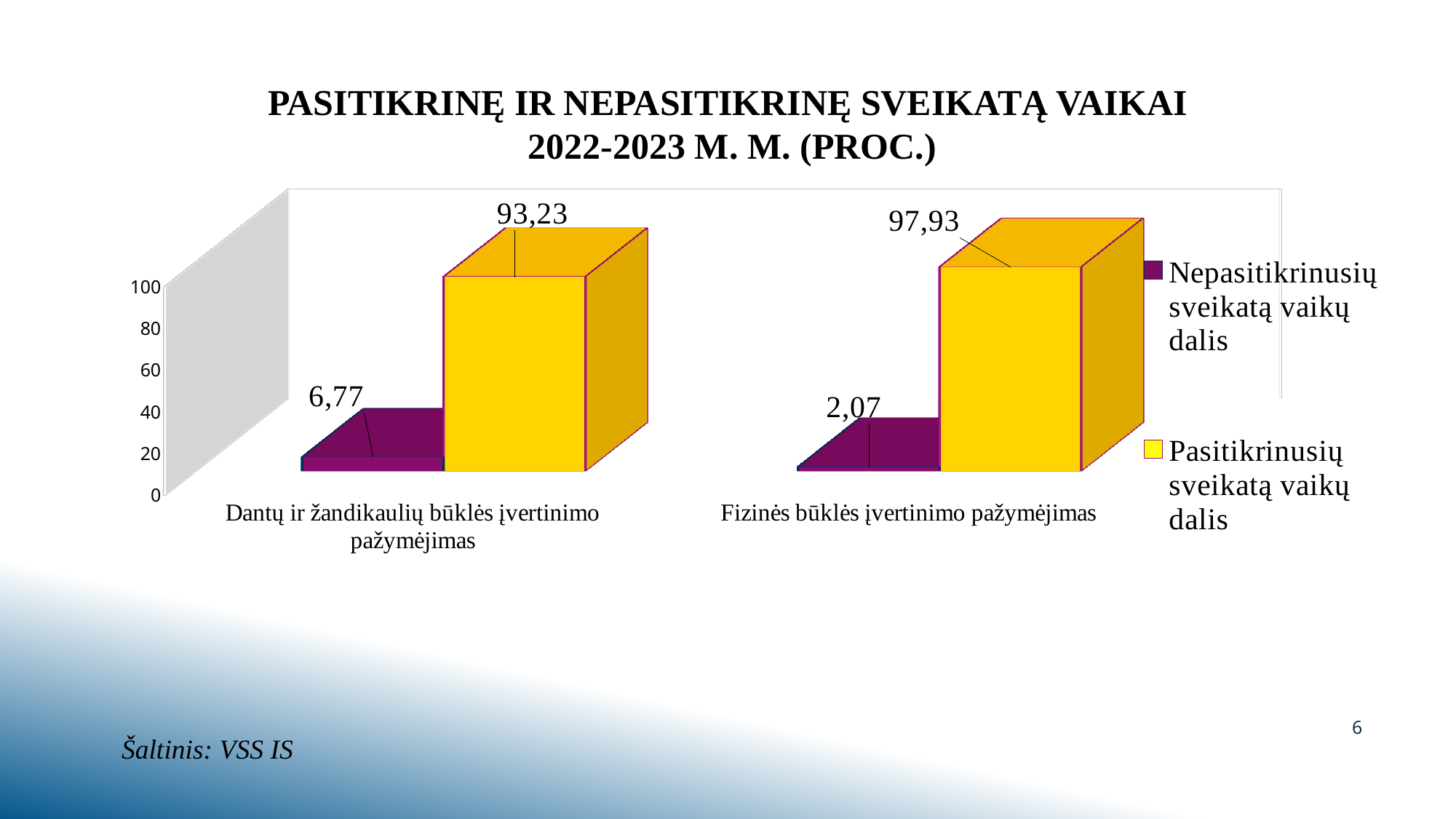
What is the difference between the "Pasitikrinusių sveikatą vaikų dalis" values for the two categories? 4,7 What is the value for "Nepasitikrinusių sveikatą vaikų dalis" in the "Fizinės būklės įvertinimo pažymėjimas" category? 2,07 What kind of chart is shown on the slide? bar chart Which category has the lowest value for "Nepasitikrinusių sveikatą vaikų dalis"? Fizinės būklės įvertinimo pažymėjimas Which category has the highest value for "Pasitikrinusių sveikatą vaikų dalis"? Fizinės būklės įvertinimo pažymėjimas What is the value for "Pasitikrinusių sveikatą vaikų dalis" in the "Fizinės būklės įvertinimo pažymėjimas" category? 97,93 What is the value for "Nepasitikrinusių sveikatą vaikų dalis" in the "Dantų ir žandikaulių būklės įvertinimo pažymėjimas" category? 6,77 Which is larger: the "Nepasitikrinusių sveikatą vaikų dalis" value for "Dantų ir žandikaulių būklės įvertinimo pažymėjimas" or for "Fizinės būklės įvertinimo pažymėjimas"? Dantų ir žandikaulių būklės įvertinimo pažymėjimas How many categories are shown on the x axis of the chart? 2 What is the value for "Pasitikrinusių sveikatą vaikų dalis" in the "Dantų ir žandikaulių būklės įvertinimo pažymėjimas" category? 93,23 How many series does the chart legend list? 2 Is the value for "Pasitikrinusių sveikatą vaikų dalis" in the "Dantų ir žandikaulių būklės įvertinimo pažymėjimas" category greater or less than 80? greater